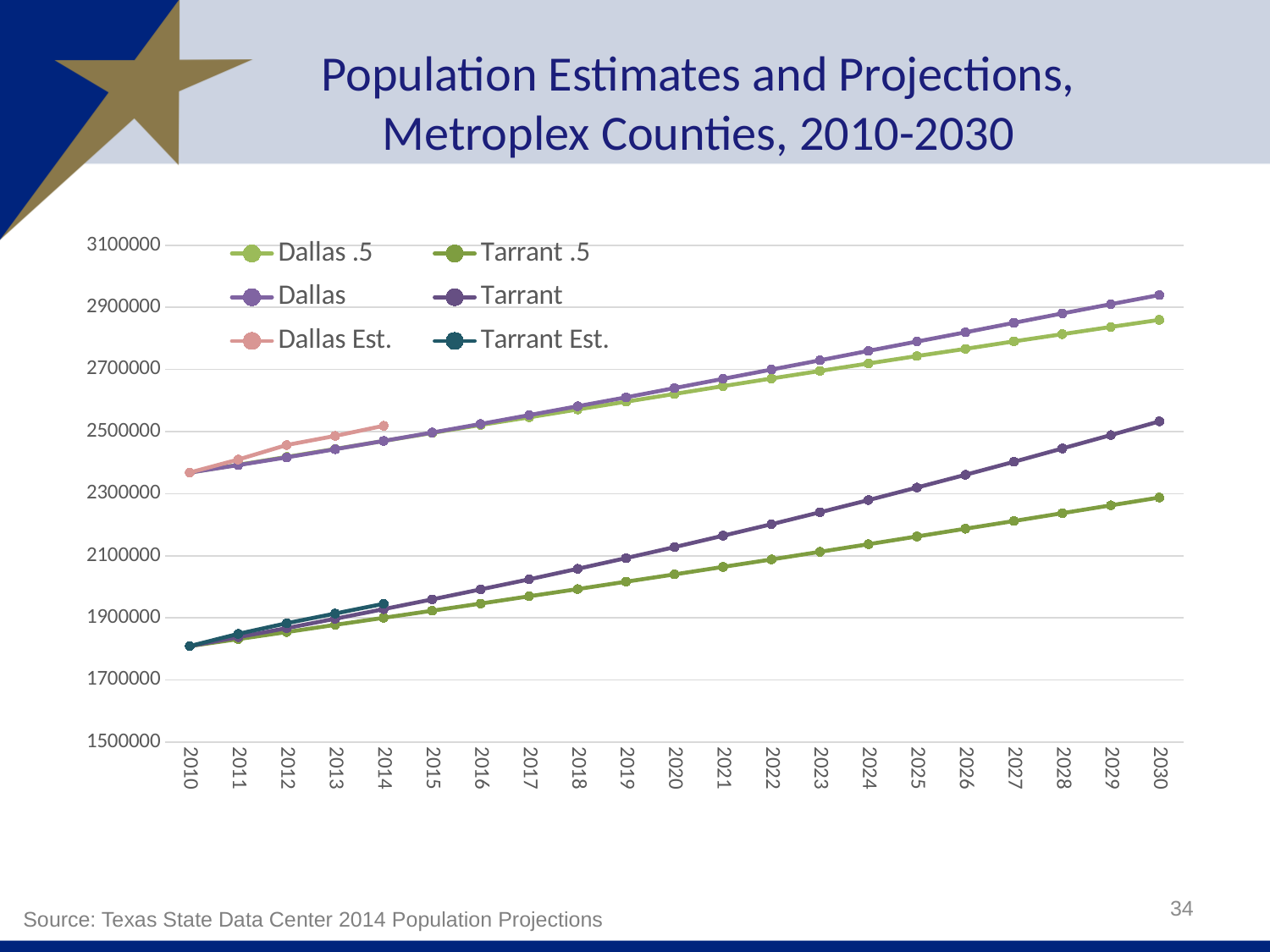
Which series has the highest value in 2030? Dallas Is the value for Tarrant in 2010 greater or less than 1900000? less How many years are shown along the x axis? 21 Which series has the lowest value in 2030? Tarrant .5 In 2030, which is larger: Tarrant or Tarrant .5? Tarrant What kind of chart is shown on the slide? Line chart What is the title of the chart? Population Estimates and Projections, Metroplex Counties, 2010-2030 Does the Dallas series rise or fall from 2010 to 2030? Rise Is the value for Dallas in 2010 greater or less than 2300000? greater In 2030, which is larger: Dallas or Tarrant? Dallas Is the value for Dallas .5 in 2030 greater or less than 2900000? less How many series does the legend list? 6